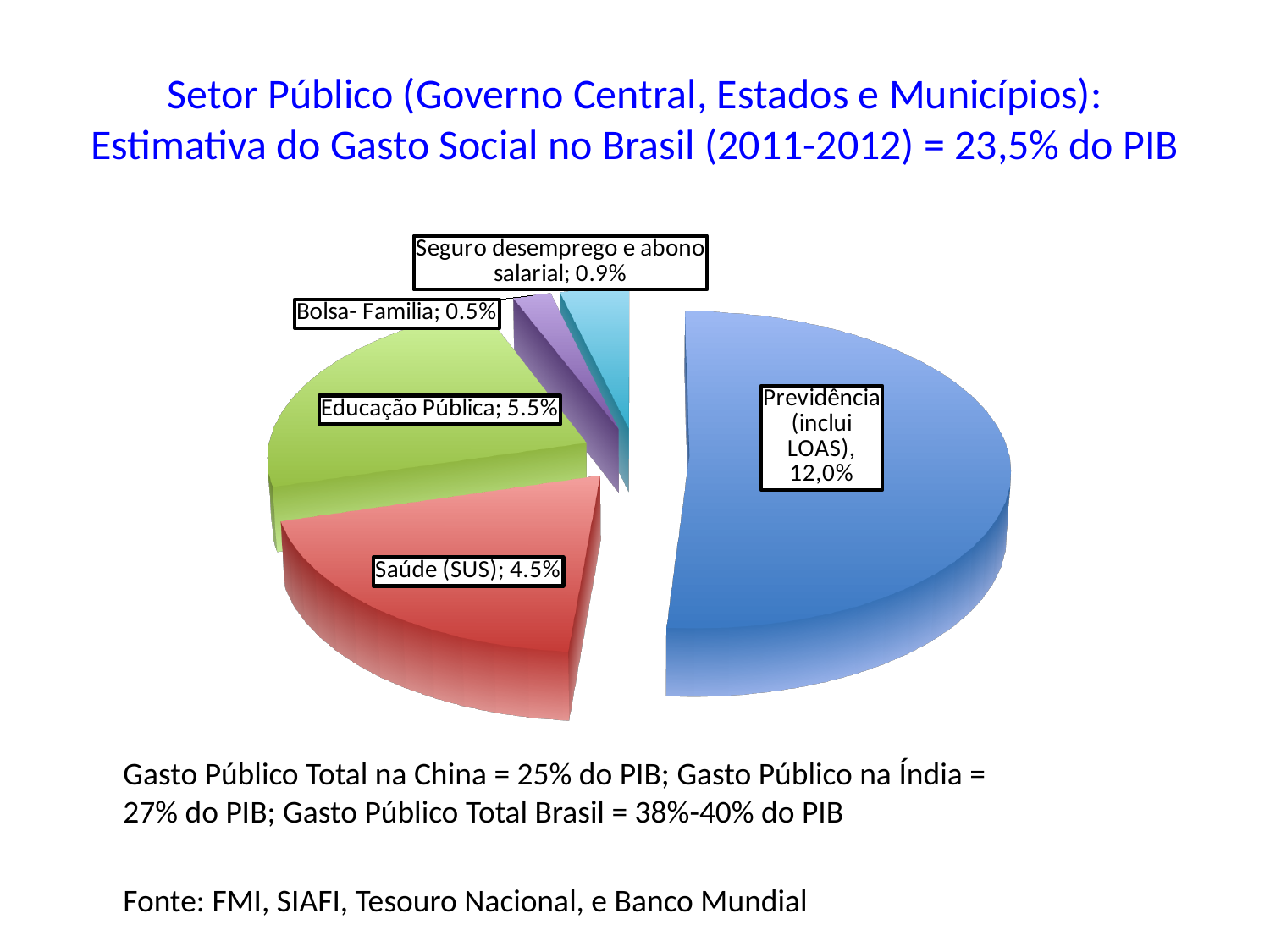
What value is shown for Previdência (inclui LOAS)? 12,0% Which category has the largest slice of the pie? Previdência (inclui LOAS) What value is shown for Bolsa-Família? 0.5% What value is shown for Saúde (SUS)? 4.5% What is the difference between the values for Educação Pública and Saúde (SUS)? 1.0% What value is shown for Seguro desemprego e abono salarial? 0.9% How many slices does the pie chart have? 5 What value is shown for Educação Pública? 5.5% Which category has the smallest slice of the pie? Bolsa-Família What is the difference between the values for Seguro desemprego e abono salarial and Bolsa-Família? 0.4% Which is larger, Educação Pública or Saúde (SUS)? Educação Pública What kind of chart is shown on the slide? pie chart